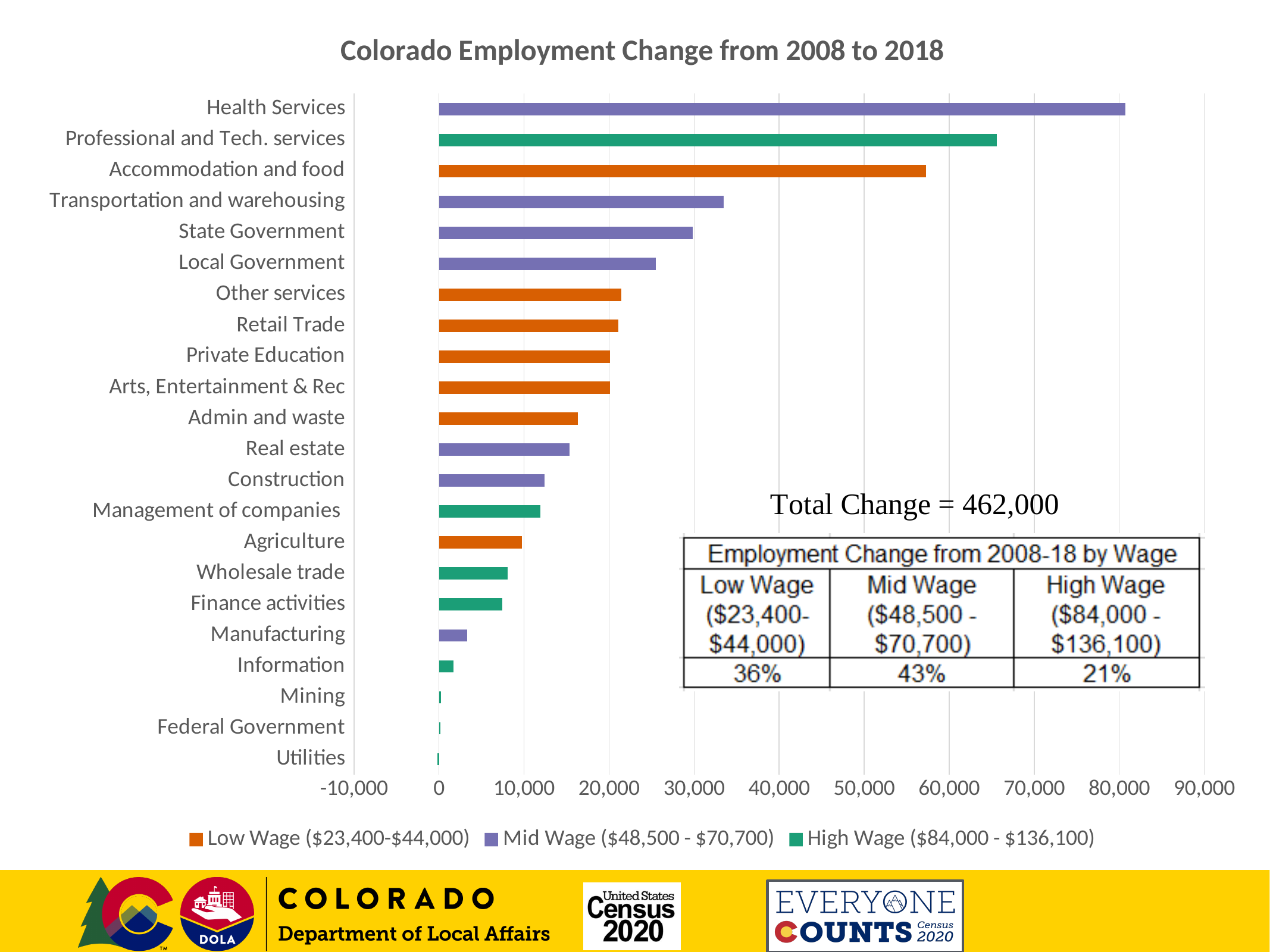
Which wage series does the Health Services bar belong to, according to the legend colours? Mid Wage ($48,500 - $70,700) How many series does the legend list? 3 Is the value for Professional and Tech. services greater or less than 60,000? greater Which category has the largest employment change? Health Services Which has the larger employment change, Accommodation and food or Transportation and warehousing? Accommodation and food Is the value for Admin and waste greater or less than 20,000? less What kind of chart is shown on the slide? bar chart How many industry categories are plotted on the chart? 22 Is the value for Transportation and warehousing greater or less than 30,000? greater What is the title of the chart? Colorado Employment Change from 2008 to 2018